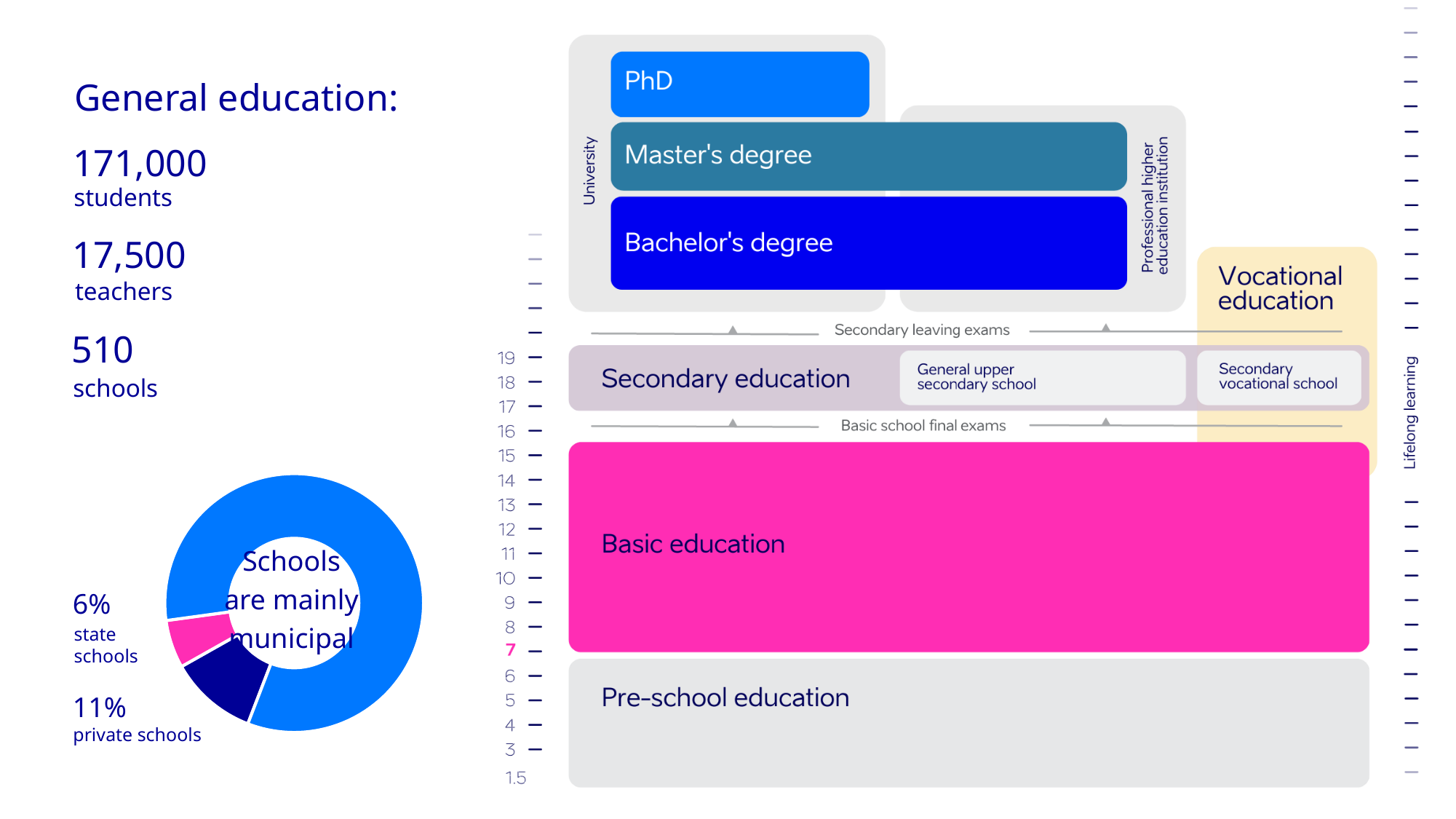
What share of schools are state schools according to the donut chart? 6% How many slices does the donut chart have? 3 What kind of chart is shown on the left of the slide? donut (pie) chart Which is larger in the donut chart: the share of private schools or the share of state schools? private schools What colour is the slice for private schools in the donut chart? dark navy blue By how many percentage points does the share of private schools exceed the share of state schools? 5 percentage points What text is written in the centre of the donut chart? Schools are mainly municipal What share of schools are private schools according to the donut chart? 11% Which category has the smallest slice in the donut chart? state schools Which category has the largest slice in the donut chart? municipal schools